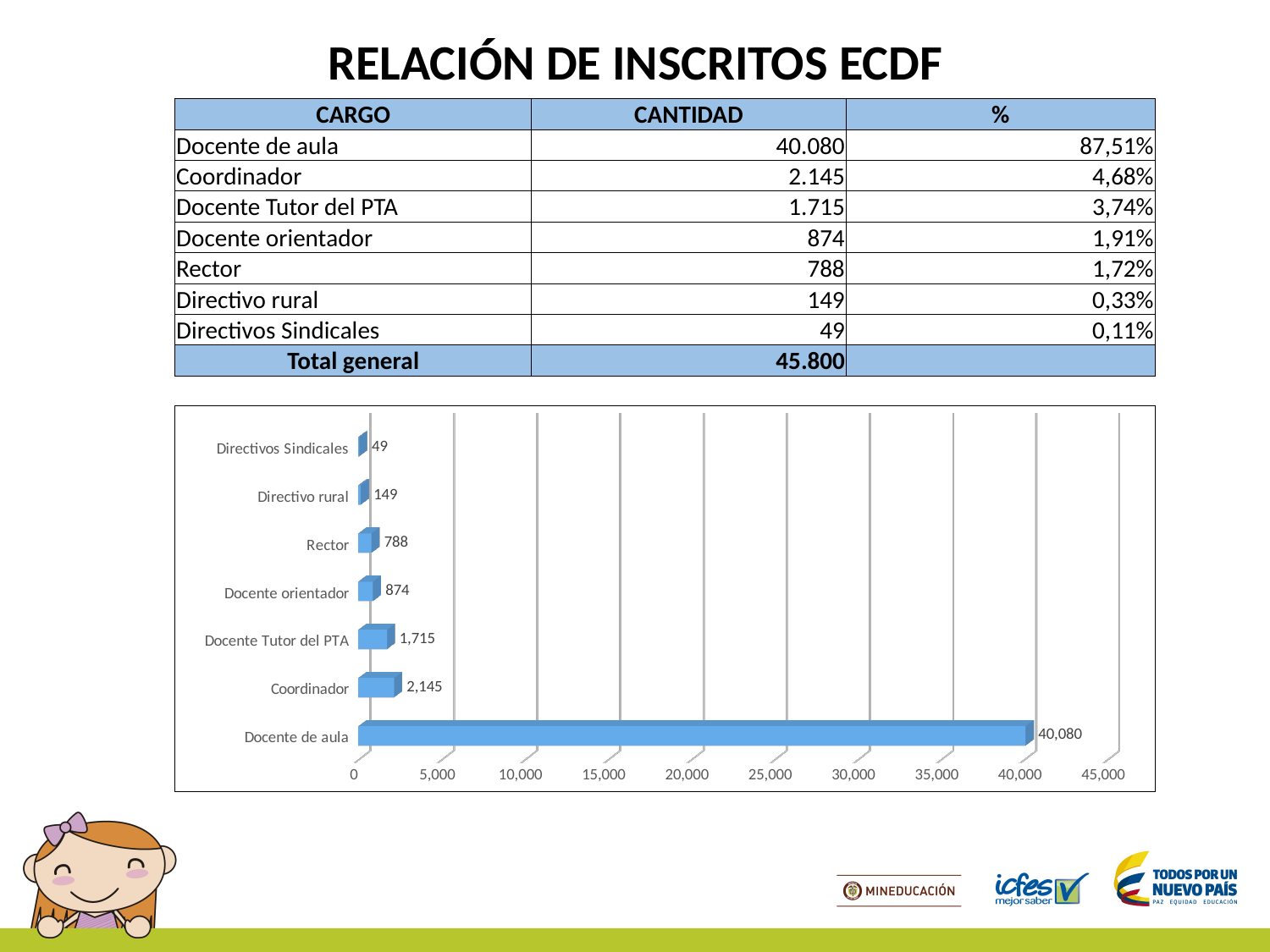
Which category has the lowest value in the bar chart? Directivos Sindicales What is the difference between the values for Coordinador and Docente Tutor del PTA in the bar chart? 430 What is the value for Docente Tutor del PTA in the bar chart? 1,715 Which is larger in the bar chart, the value for Rector or the value for Docente orientador? Docente orientador Is the value for Docente de aula in the bar chart greater or less than 35,000? greater What is the value for Docente de aula in the bar chart? 40,080 What type of chart is shown on the slide? bar chart What is the value for Directivo rural in the bar chart? 149 Which category has the highest value in the bar chart? Docente de aula What is the value for Coordinador in the bar chart? 2,145 What is the highest value shown on the horizontal axis of the bar chart? 45,000 How many categories does the bar chart show? 7